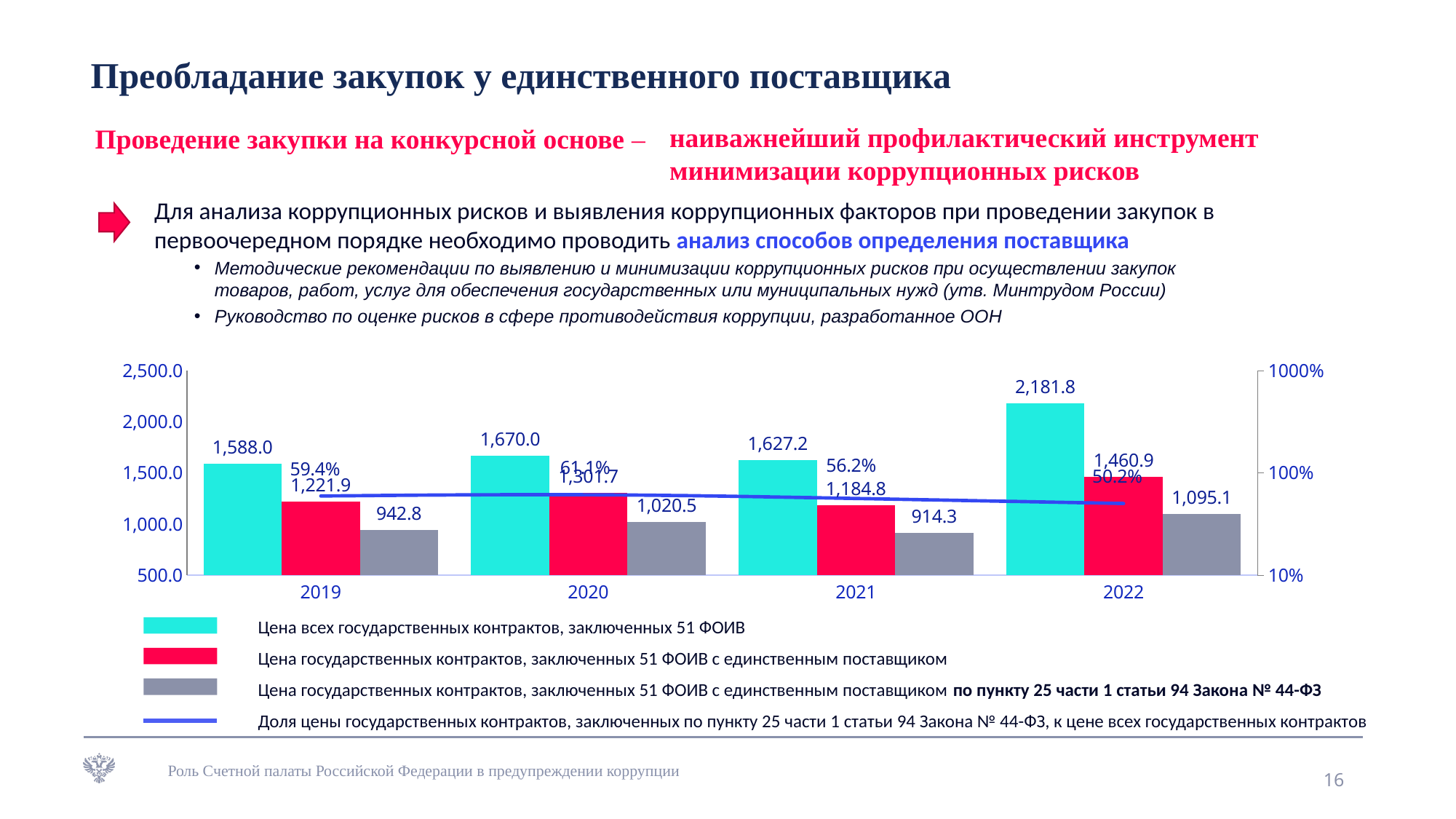
In which year is the grey series (contracts under пункт 25 части 1 статьи 94) the lowest? 2021 What is the value of 'Цена всех государственных контрактов, заключенных 51 ФОИВ' for 2022? 2,181.8 In which year is 'Цена всех государственных контрактов, заключенных 51 ФОИВ' the highest? 2022 What kind of chart is shown on the slide? A bar chart with a line series How many series does the chart legend list? 4 By how much does 'Цена всех государственных контрактов, заключенных 51 ФОИВ' in 2022 exceed the value in 2021? 554.6 What is the value of 'Цена государственных контрактов, заключенных 51 ФОИВ с единственным поставщиком' for 2020? 1,301.7 What is the value of the grey series (contracts under пункт 25 части 1 статьи 94 Закона № 44-ФЗ) for 2021? 914.3 In 2019, which is larger: the red series (с единственным поставщиком) or the grey series (по пункту 25 части 1 статьи 94)? The red series (1,221.9) What share does the line series show for 2019? 59.4% How many years are shown on the x axis of the chart? 4 Does the line series (share of contracts under пункт 25 части 1 статьи 94) rise or fall from 2020 to 2022? It falls